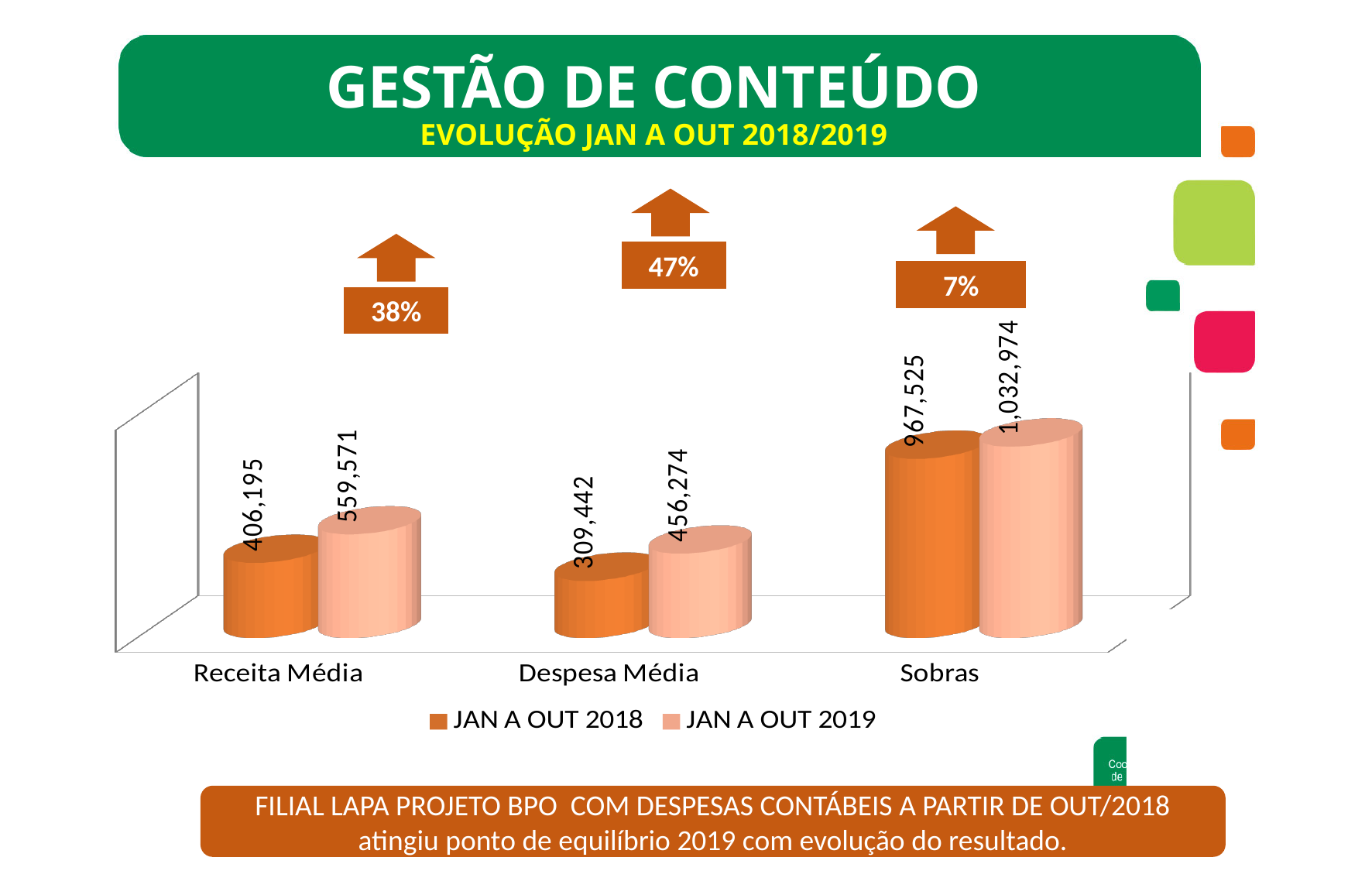
What is the value for Receita Média in the JAN A OUT 2018 series? 406,195 How many series does the legend list? 2 How many categories are shown on the x axis? 3 What is the value for Sobras in the JAN A OUT 2019 series? 1,032,974 What is the value for Sobras in the JAN A OUT 2018 series? 967,525 What is the difference between the JAN A OUT 2019 and JAN A OUT 2018 values for Receita Média? 153,376 Which is larger for Despesa Média: the JAN A OUT 2018 value or the JAN A OUT 2019 value? JAN A OUT 2019 Which category has the lowest value in the JAN A OUT 2018 series? Despesa Média What kind of chart is shown on the slide? Bar chart Which category has the highest value in the JAN A OUT 2019 series? Sobras What percentage growth is shown above the Despesa Média bars? 47% What is the value for Despesa Média in the JAN A OUT 2019 series? 456,274